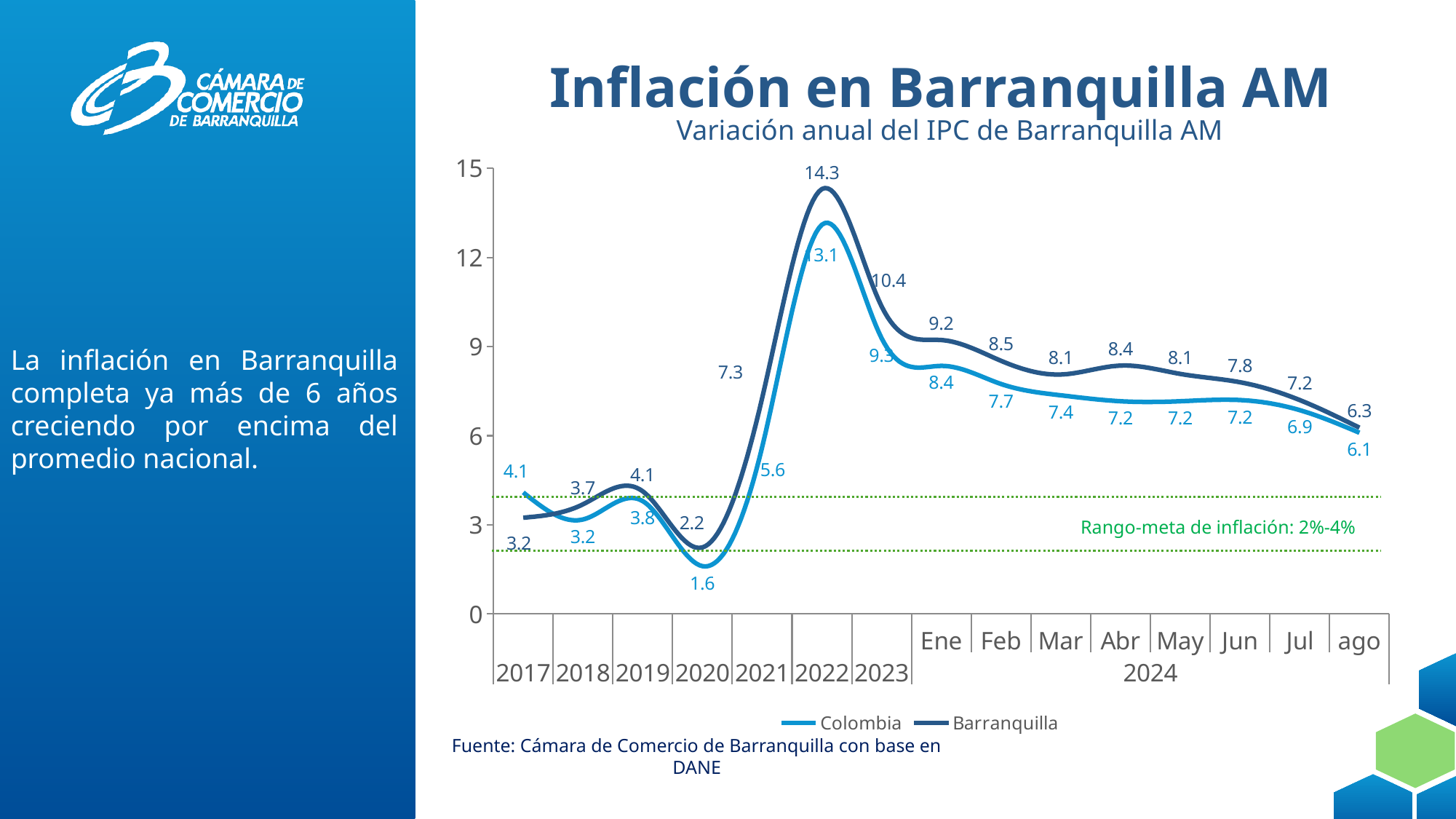
What inflation target range is indicated by the dotted lines on the chart? 2%-4% In which year or month does the Colombia series reach its highest value? 2022 How many data points are plotted along the x axis for each series? 15 Which series has the higher value in 2017, Colombia or Barranquilla? Colombia What is the Barranquilla value for ago 2024? 6.3 What is the Barranquilla value for 2022? 14.3 How many series does the legend list? 2 What type of chart is shown on the slide? Line chart What is the Colombia value for 2020? 1.6 What is the difference between the Barranquilla and Colombia values for 2023? 1.1 In which year or month does the Barranquilla series reach its lowest value? 2020 Is the Barranquilla value for 2021 greater or less than 6? greater